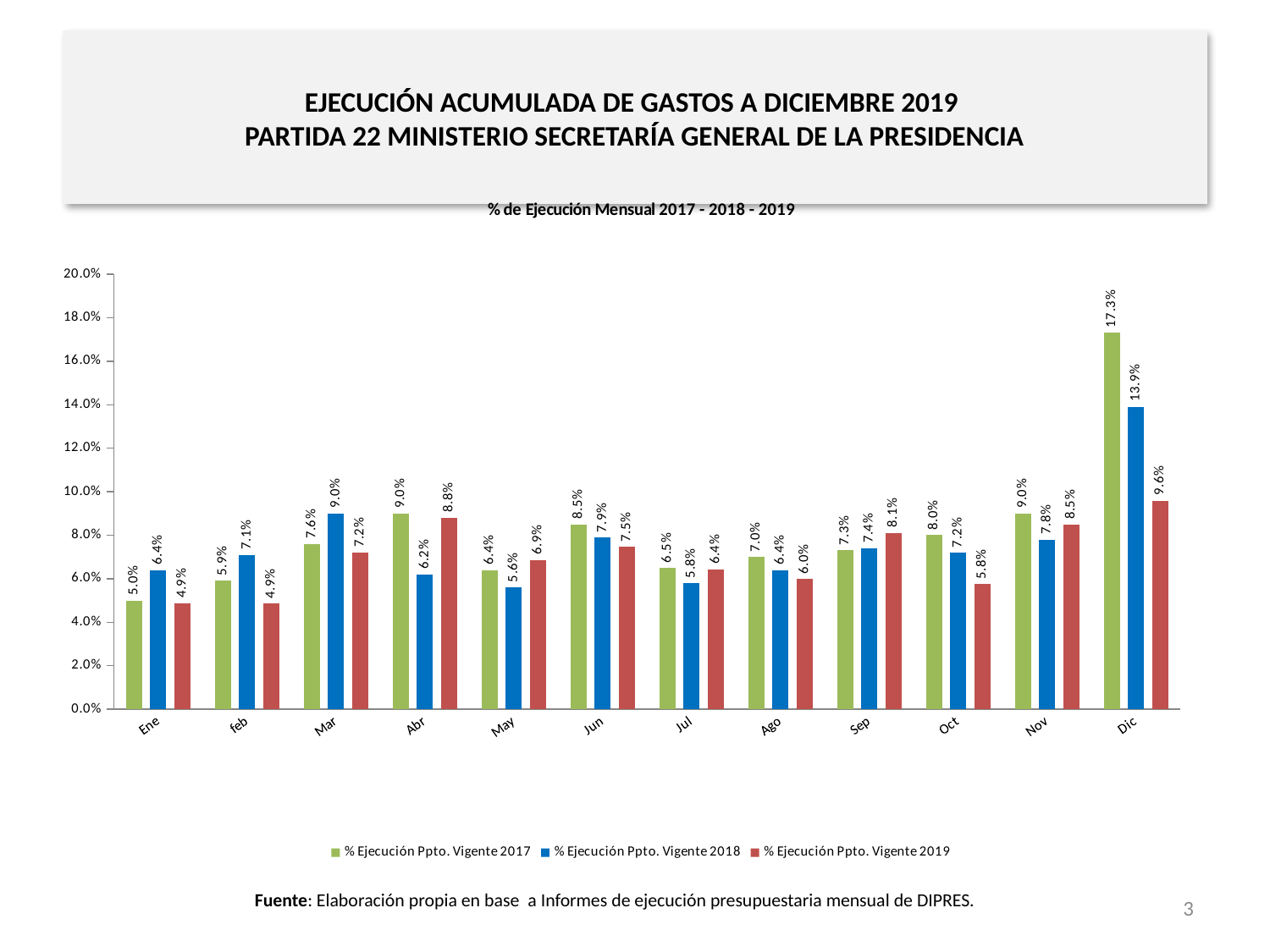
Which month has the highest value in the % Ejecución Ppto. Vigente 2019 series? Dic What is the title of the chart? % de Ejecución Mensual 2017 - 2018 - 2019 How many series does the legend list? 3 How many months are shown on the x axis? 12 What is the value for Mar in the % Ejecución Ppto. Vigente 2018 series? 9.0% Is the value for Dic in the % Ejecución Ppto. Vigente 2018 series greater or less than 12.0%? greater What is the value for Sep in the % Ejecución Ppto. Vigente 2019 series? 8.1% What is the value for Dic in the % Ejecución Ppto. Vigente 2017 series? 17.3% Which month has the lowest value in the % Ejecución Ppto. Vigente 2017 series? Ene What is the difference between the 2017 and 2018 values for Dic? 3.4% What kind of chart is shown on the slide? Bar chart For Abr, which series has the larger value: % Ejecución Ppto. Vigente 2017 or % Ejecución Ppto. Vigente 2018? % Ejecución Ppto. Vigente 2017